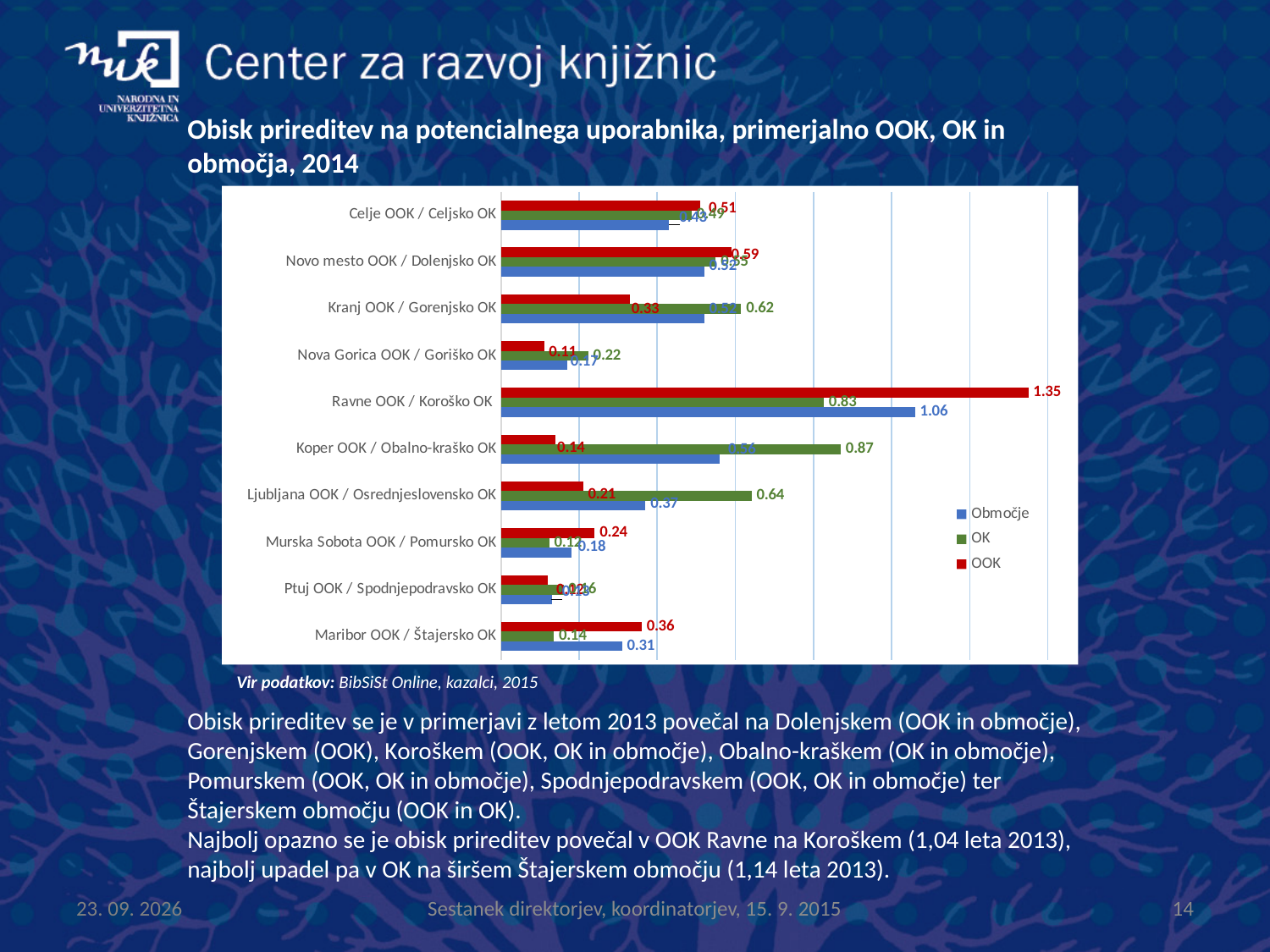
How many categories are shown on the chart? 10 How many series does the legend list? 3 What is the OK value for Ljubljana OOK / Osrednjeslovensko OK? 0.64 What is the Območje value for Ravne OOK / Koroško OK? 1.06 What is the difference between the OOK and Območje values for Ravne OOK / Koroško OK? 0.29 For Koper OOK / Obalno-kraško OK, which is larger: the OK value or the OOK value? OK What kind of chart is shown on the slide? Bar chart Which category has the highest OK value? Koper OOK / Obalno-kraško OK What is the OOK value for Ravne OOK / Koroško OK? 1.35 What is the OOK value for Maribor OOK / Štajersko OK? 0.36 Which category has the highest OOK value? Ravne OOK / Koroško OK What is the OK value for Koper OOK / Obalno-kraško OK? 0.87